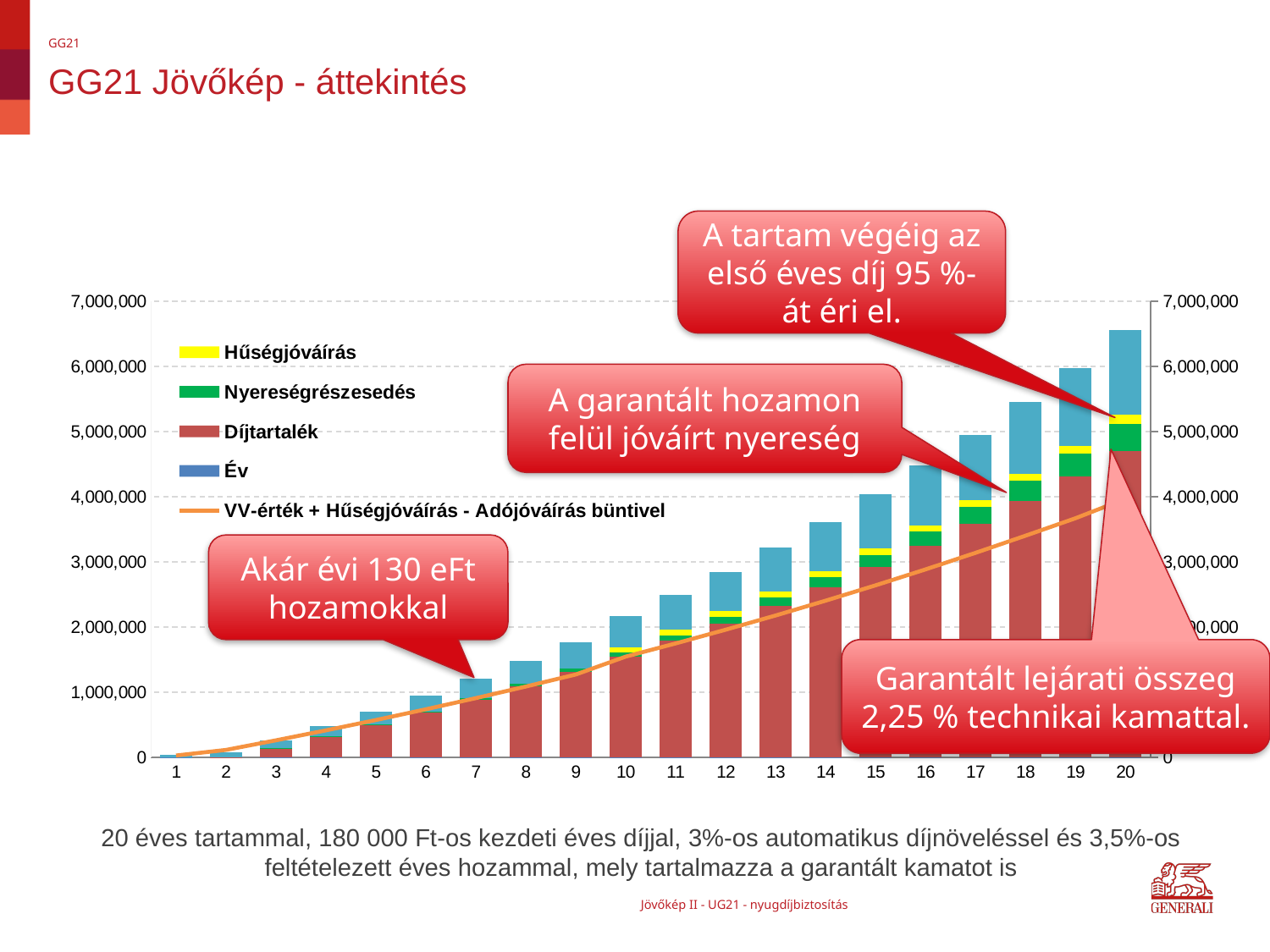
Do the stacked bar totals rise or fall as the year increases along the x axis? rise Is the total of the stacked bar for year 5 greater or less than 1,000,000? less What colour is used for the Hűségjóváírás series in the legend? yellow Which year has the tallest stacked bar? 20 Is the total of the stacked bar for year 20 greater or less than 6,000,000? greater What kind of chart is shown on the slide? combination bar and line chart Is the total of the stacked bar for year 14 greater or less than 3,000,000? greater Which stacked bar is taller, year 12 or year 8? 12 Which year has the shortest stacked bar? 1 How many series does the chart's legend list? 5 How many categories (years) are shown on the x axis of the chart? 20